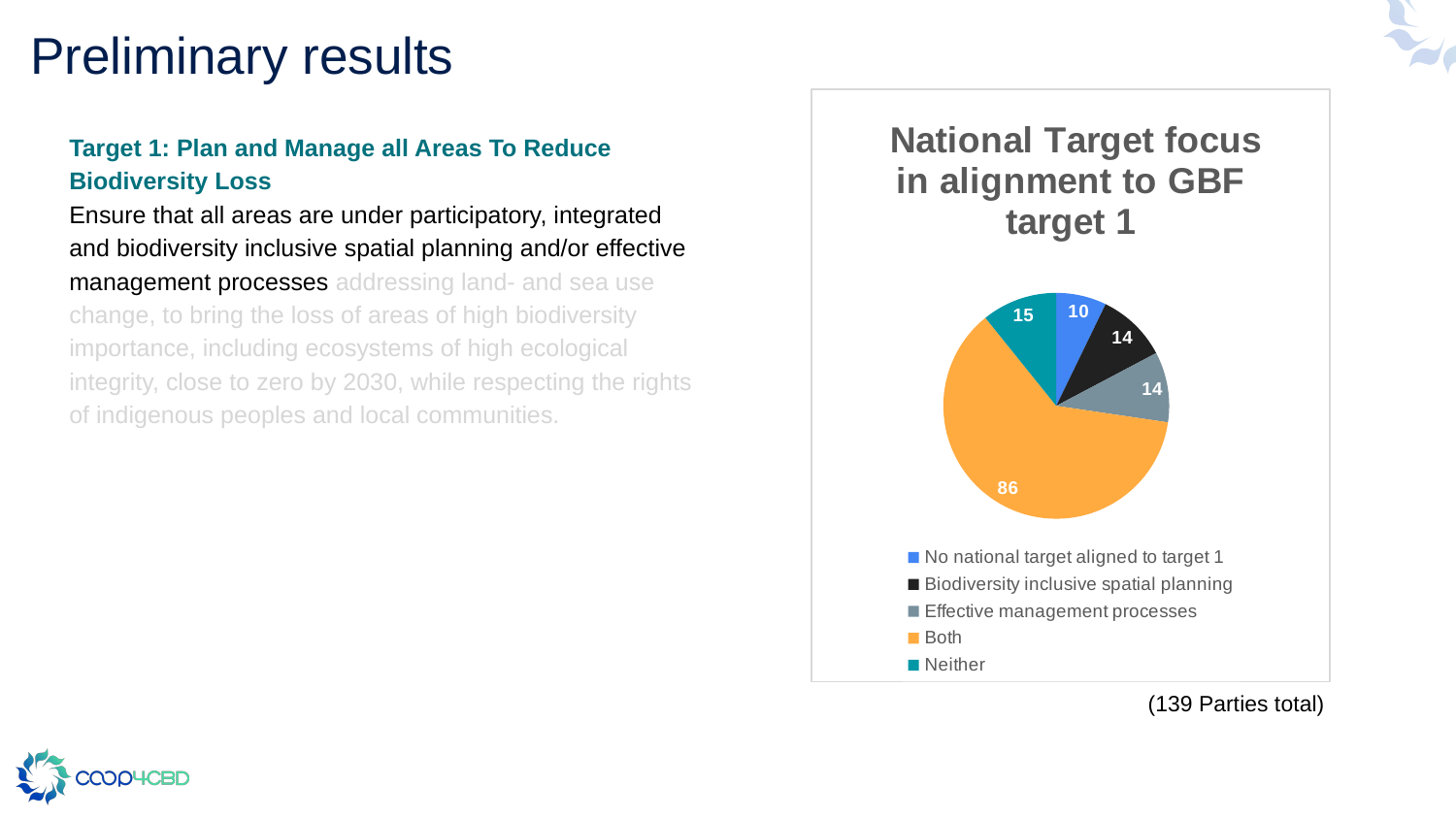
What is the difference between the 'Both' value and the 'Neither' value? 71 What is the value for 'No national target aligned to target 1'? 10 What is the value for 'Neither'? 15 Which category has the largest slice of the pie? Both What is the title of the chart? National Target focus in alignment to GBF target 1 What is the value for the 'Both' slice? 86 Which is larger, 'Neither' or 'No national target aligned to target 1'? Neither What is the value for 'Effective management processes'? 14 How many slices does the pie chart have? 5 What type of chart is shown on the slide? Pie chart Which category has the smallest slice of the pie? No national target aligned to target 1 How many entries does the legend list? 5